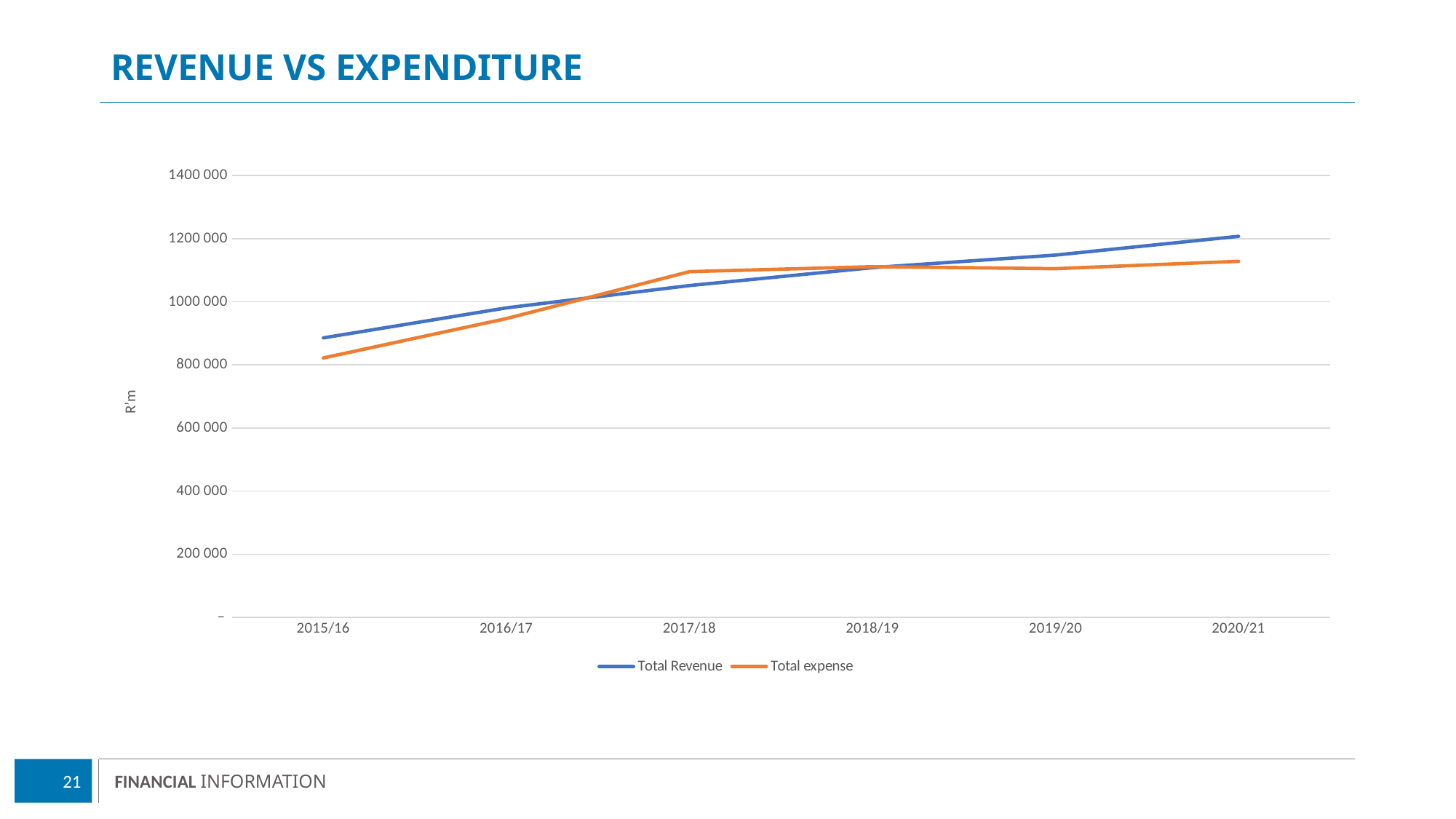
What is the label on the vertical axis? R'm Is the Total expense value for 2015/16 greater or less than 1000 000? less Is the Total expense value for 2020/21 greater or less than 1200 000? less How many financial years are plotted along the x axis? 6 In which year is Total Revenue at its lowest? 2015/16 Does Total Revenue rise or fall from 2015/16 to 2020/21? rise In 2017/18, which is larger: Total Revenue or Total expense? Total expense What kind of chart is shown on the slide? line chart Is the Total Revenue value for 2015/16 greater or less than 1000 000? less In 2020/21, which is larger: Total Revenue or Total expense? Total Revenue How many series does the legend list? 2